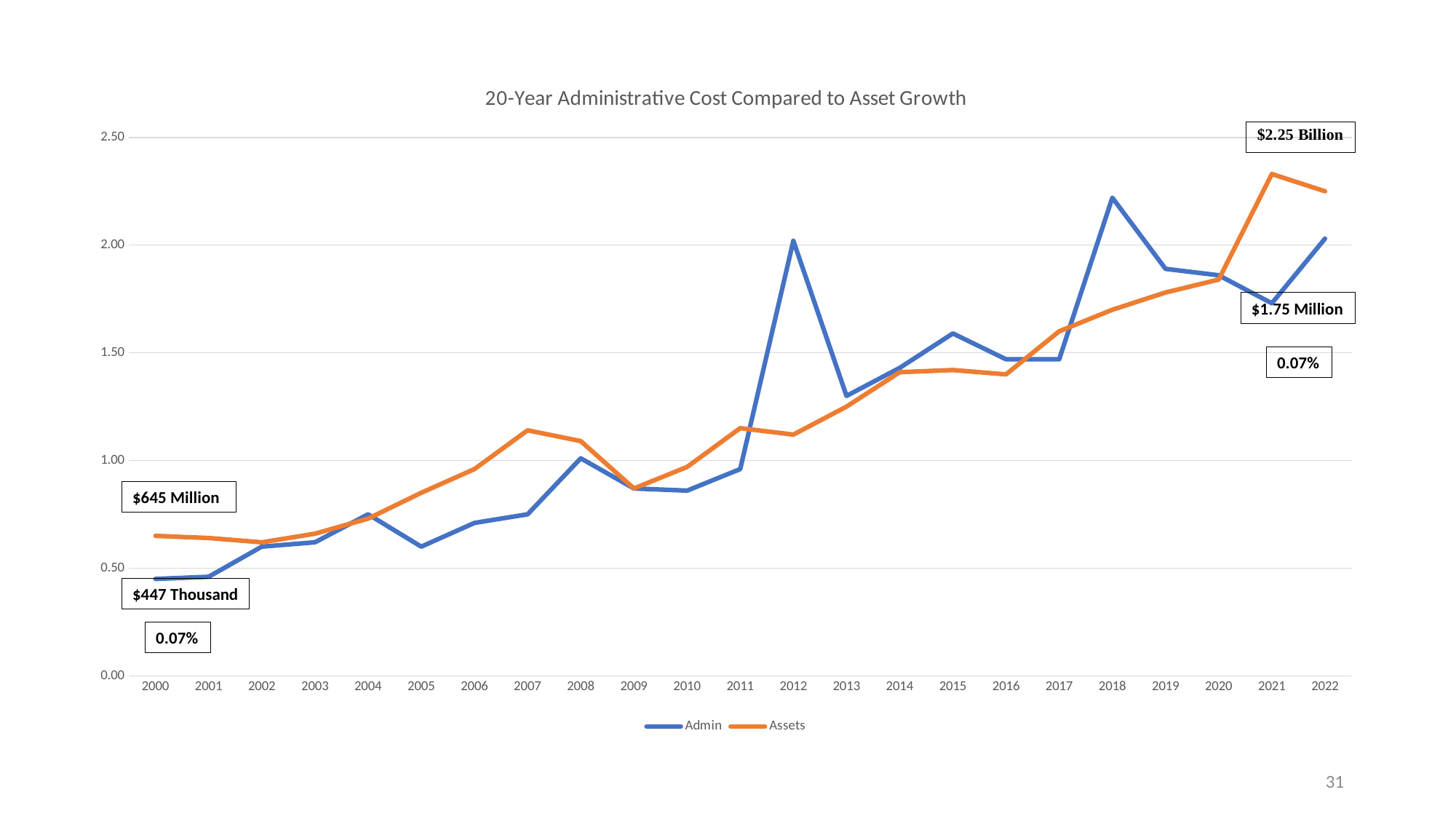
In 2012, which series has the larger value, Admin or Assets? Admin In 2007, which series has the larger value, Admin or Assets? Assets Is the value for Admin in 2000 greater or less than 0.50? less In which year does the Assets series reach its highest value? 2021 How many years are plotted along the x axis? 23 In which year does the Admin series reach its highest value? 2018 What is the title of the chart? 20-Year Administrative Cost Compared to Asset Growth How many series does the legend list? 2 What type of chart is shown on the slide? line chart Is the value for Assets in 2021 greater or less than 2.00? greater Is the value for Admin in 2018 greater or less than 2.00? greater